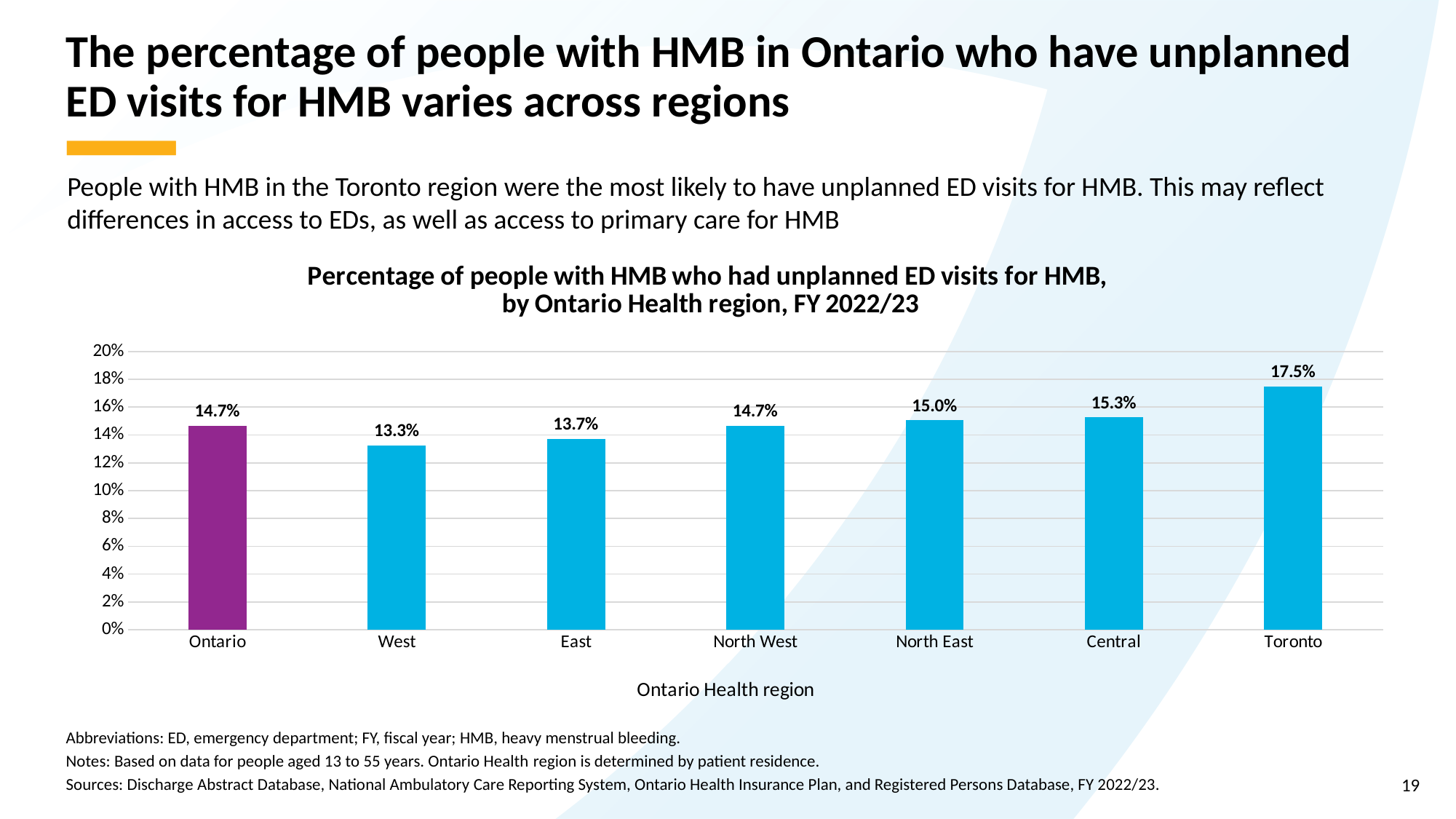
What type of chart is shown on the slide? Bar chart What is the value shown for the West region? 13.3% How many bars are shown in the chart? 7 What is the difference between the Central and East values? 1.6 percentage points Is the value for Toronto greater or less than 16%? greater Which region has the lowest percentage of people with HMB who had unplanned ED visits for HMB? West What is the percentage of people with HMB who had unplanned ED visits for HMB in the Toronto region? 17.5% What is the difference in percentage points between Toronto and West? 4.2 percentage points Which bar is coloured differently (purple) from the others? Ontario Which region has the highest percentage of people with HMB who had unplanned ED visits for HMB? Toronto What is the value shown for Ontario overall? 14.7% Which has a higher value, North East or East? North East